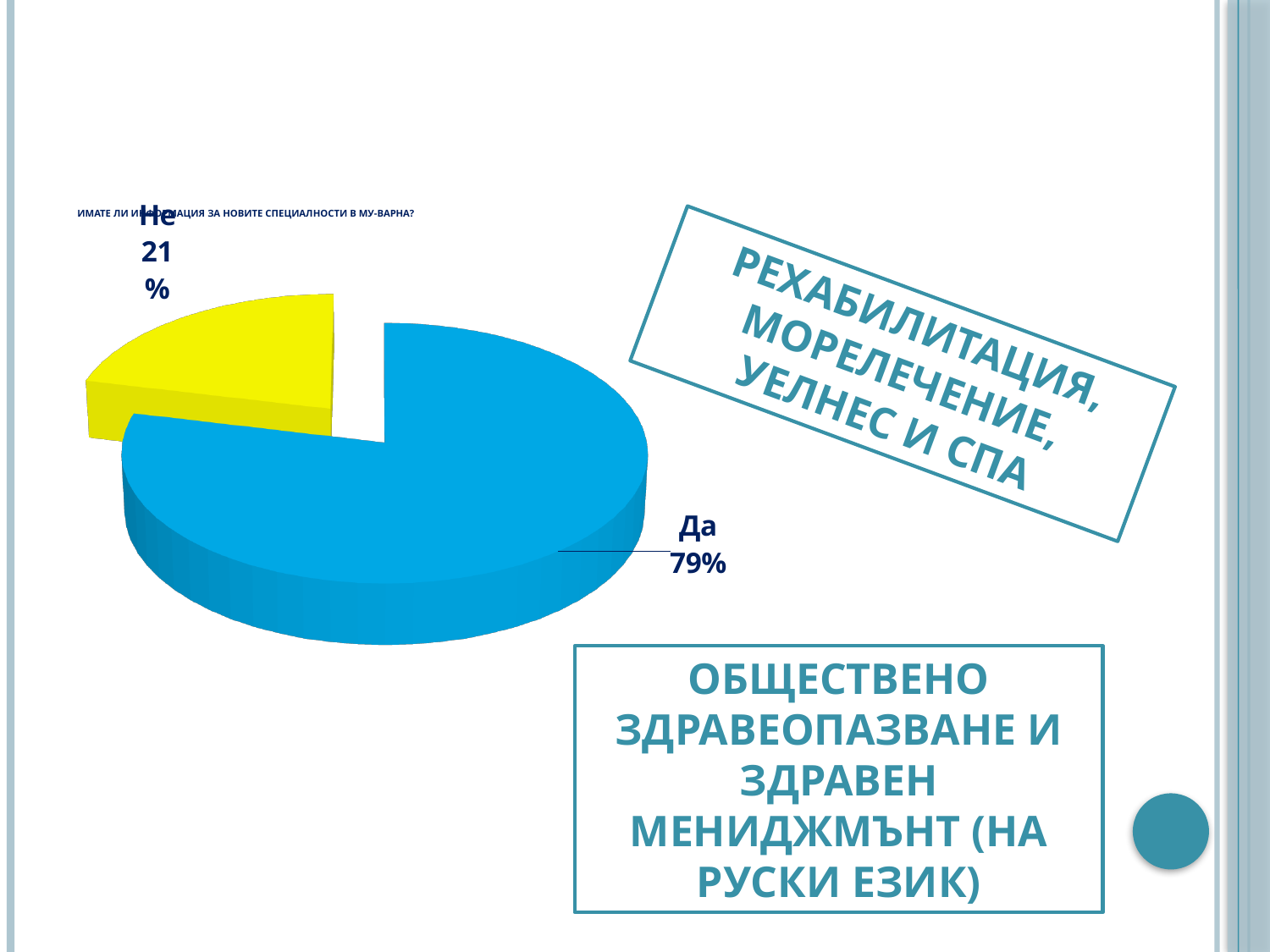
Which slice of the pie chart is the smallest? Не What colour is the "Не" slice of the pie chart? Yellow What share of the pie chart is labelled "Да"? 79% What share of the pie chart is labelled "Не"? 21% What kind of chart is shown on the slide? Pie chart Which slice of the pie chart is the largest? Да Which is larger in the pie chart, "Да" or "Не"? Да By how many percentage points does the "Да" slice exceed the "Не" slice? 58 percentage points How many slices does the pie chart have? 2 What do the two slices of the pie chart add up to? 100% Is the share for "Не" greater or less than 25%? less What colour is the "Да" slice of the pie chart? Blue